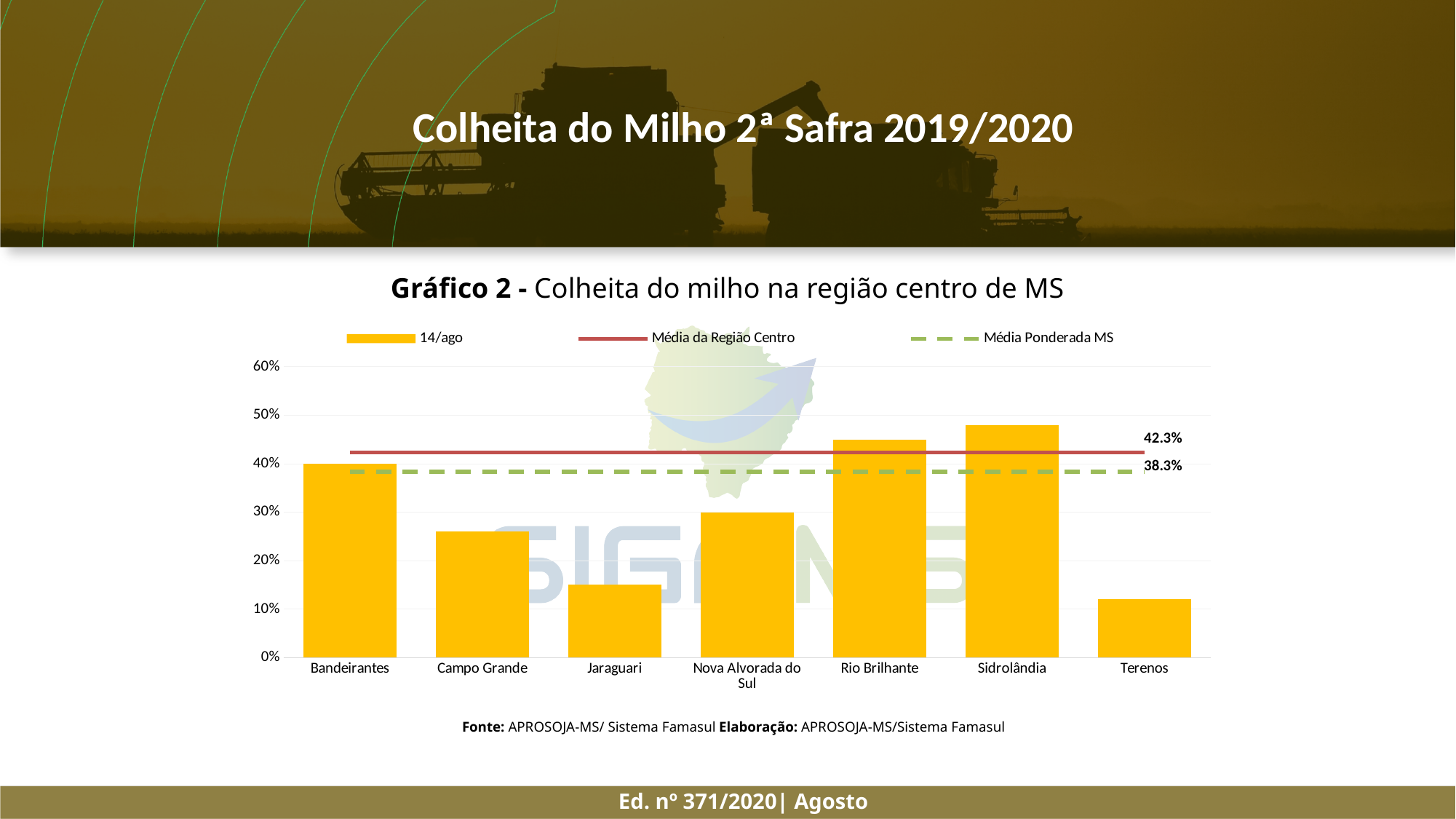
How many municipalities are shown on the x axis of the chart? 7 Which has a higher bar, Rio Brilhante or Campo Grande? Rio Brilhante What is the legend label for the yellow bars in the chart? 14/ago Which municipality has the lowest bar in the chart? Terenos Which municipality has the highest bar in the chart? Sidrolândia What value is shown for the Média da Região Centro line? 42.3% What value is shown for the Média Ponderada MS line? 38.3% Is the value for Jaraguari greater or less than 20%? less Is the value for Sidrolândia greater or less than 40%? greater How many series does the chart legend list? 3 What kind of chart is shown on the slide? Combination bar and line chart What is the difference between the Média da Região Centro (42.3%) and the Média Ponderada MS (38.3%)? 4.0%